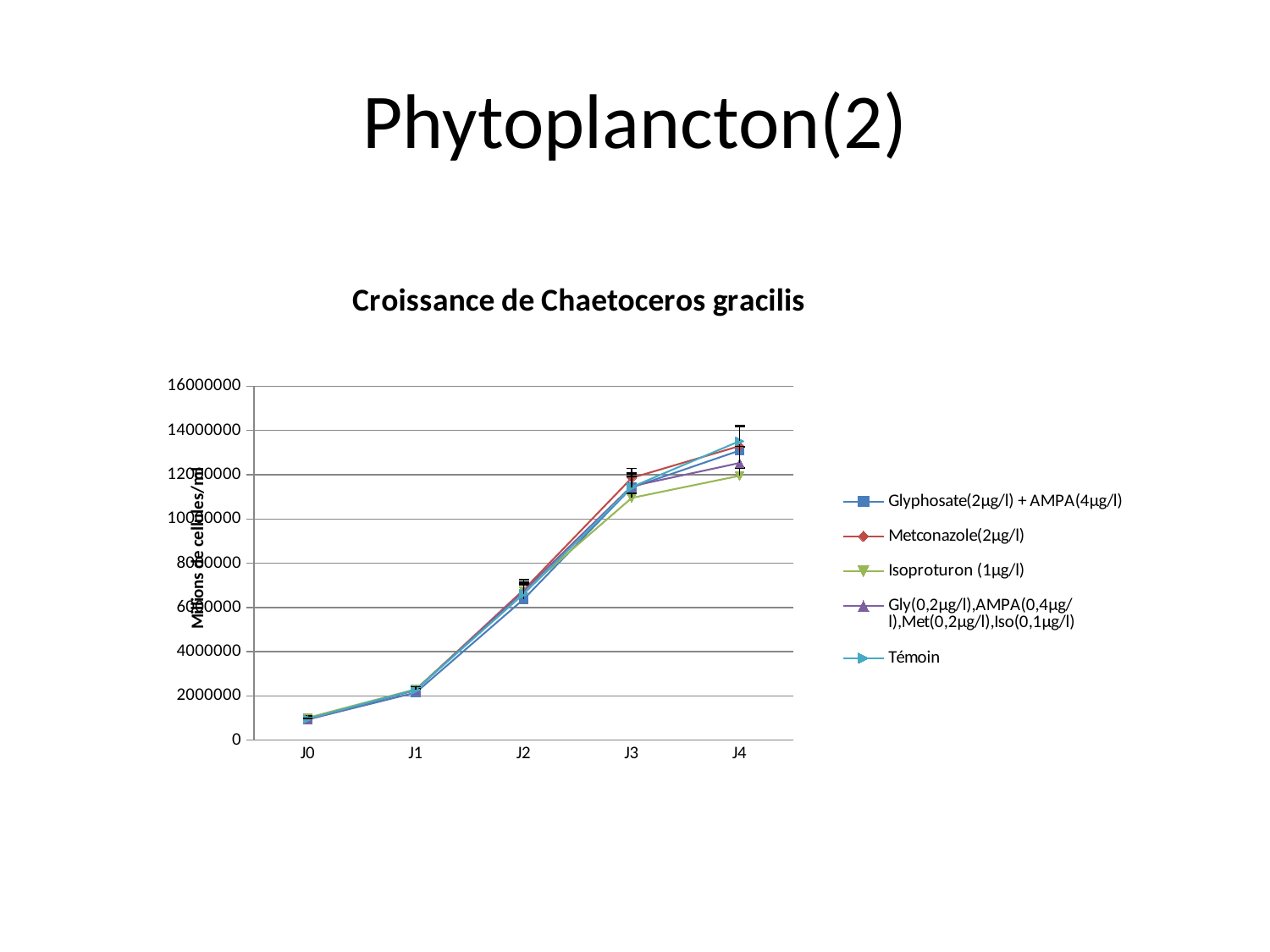
Do the values rise or fall from J0 to J4? rise Is the value for Isoproturon (1µg/l) at J2 greater or less than 8000000? less Is the value for Metconazole(2µg/l) at J3 greater or less than 10000000? greater Which series is drawn with a green line? Isoproturon (1µg/l) How many series does the legend list? 5 What kind of chart is shown on the slide? line chart How many categories are shown on the x axis? 5 Is the value for Témoin at J4 greater or less than 12000000? greater Which series has the lowest value at J4? Isoproturon (1µg/l) What is the title of the chart? Croissance de Chaetoceros gracilis